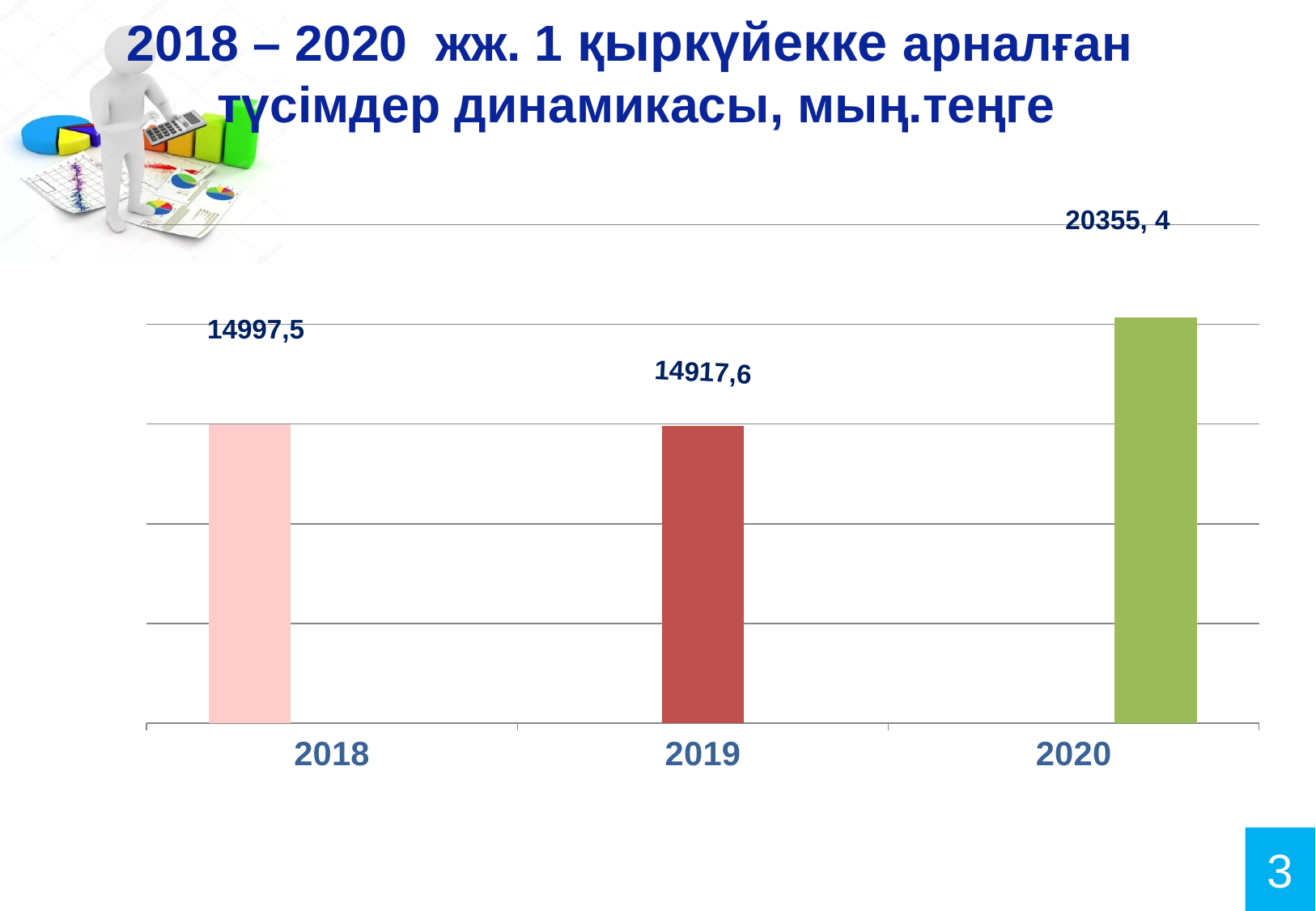
How many years are shown on the x axis? 3 What kind of chart is shown on the slide? Bar chart What is the value for 2019? 14917,6 What is the difference between the values for 2020 and 2018? 5357,9 What is the value for 2020? 20355, 4 Which year has the lowest value? 2019 What is the value for 2018? 14997,5 Which is larger, the value for 2020 or the value for 2019? 2020 What colour is the bar for 2020? Green Does the value rise or fall from 2019 to 2020? Rise What is the difference between the values for 2018 and 2019? 79,9 Which year has the highest value? 2020